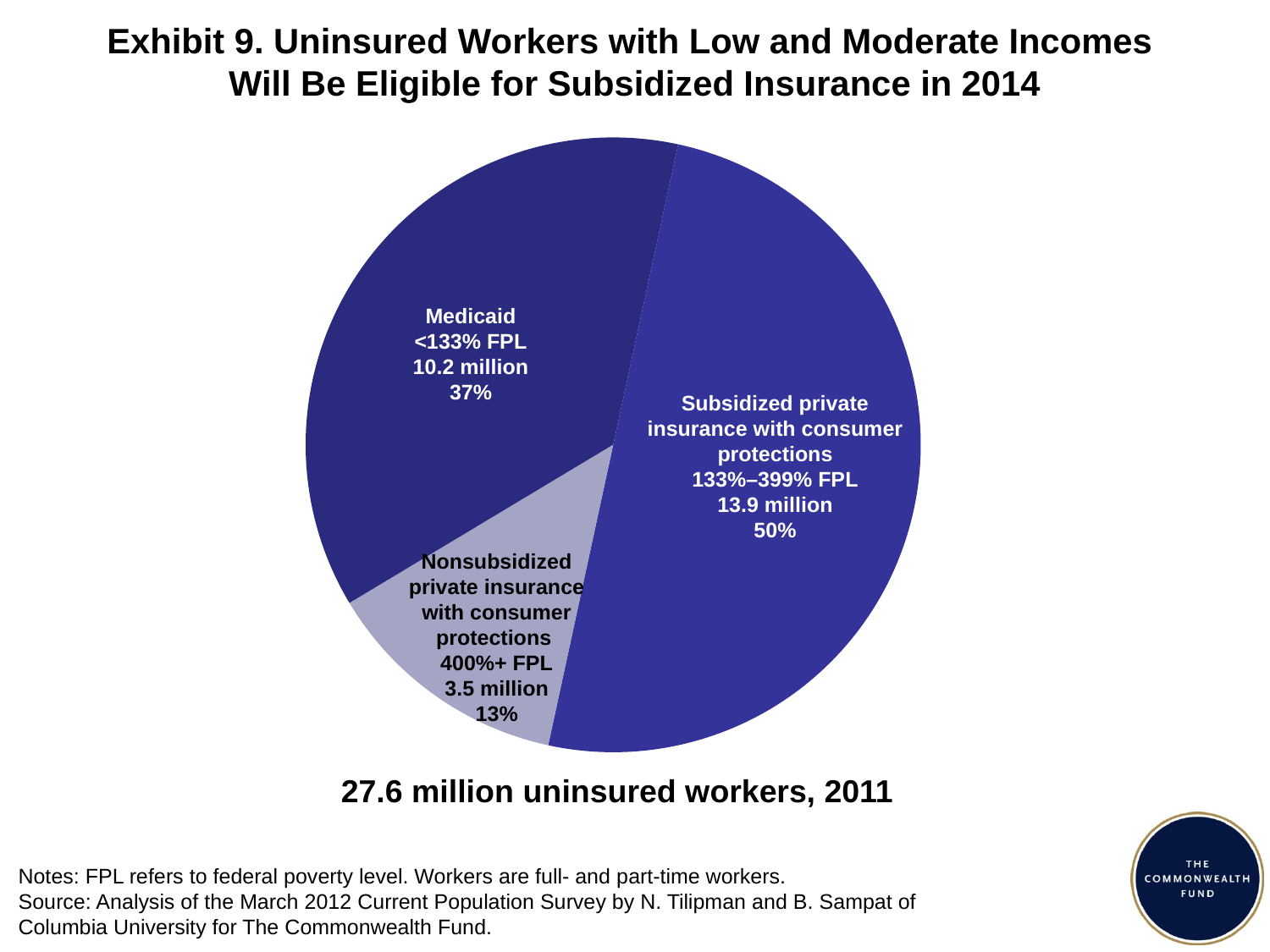
Which is larger: the Medicaid slice or the Nonsubsidized private insurance slice? Medicaid What percentage of uninsured workers fall in the Subsidized private insurance with consumer protections (133%–399% FPL) slice? 50% How many million uninsured workers are in the Medicaid (<133% FPL) slice? 10.2 million What kind of chart is shown on the slide? Pie chart What share of the pie does the Medicaid (<133% FPL) slice represent? 37% How many million uninsured workers are in the Nonsubsidized private insurance with consumer protections (400%+ FPL) slice? 3.5 million What is the total number of uninsured workers shown below the pie chart? 27.6 million Which slice of the pie is the smallest? Nonsubsidized private insurance with consumer protections (400%+ FPL) What is the exhibit number given in the slide title? Exhibit 9 How many slices does the pie chart have? 3 What is the difference in millions between the Subsidized private insurance slice and the Medicaid slice? 3.7 million Which slice of the pie is the largest? Subsidized private insurance with consumer protections (133%–399% FPL)